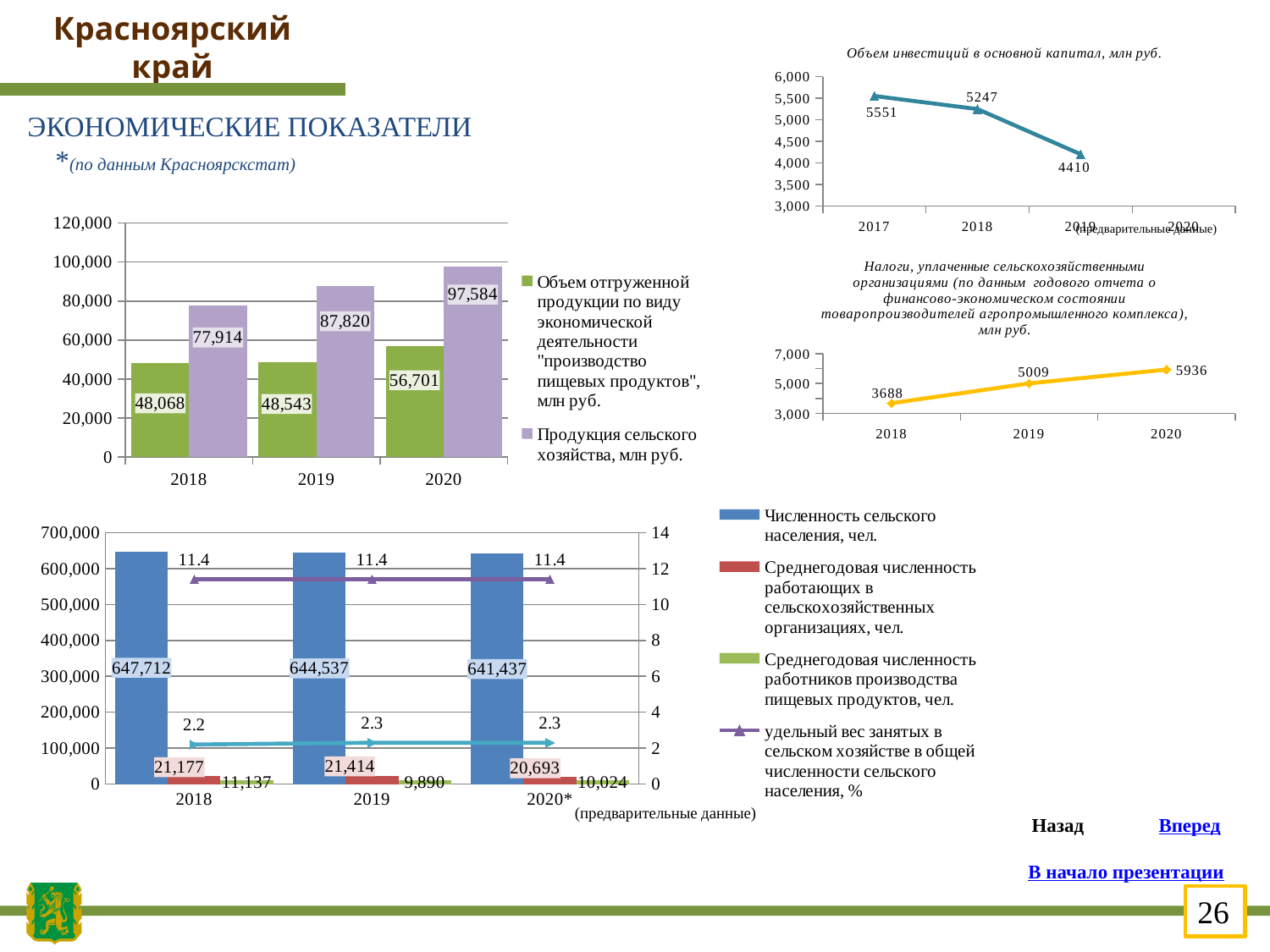
In the chart 'Объем инвестиций в основной капитал, млн руб.', what is the value for 2019? 4410 In the bottom-left chart, which is larger in 2019: 'Среднегодовая численность работающих в сельскохозяйственных организациях' or 'Среднегодовая численность работников производства пищевых продуктов'? Среднегодовая численность работающих в сельскохозяйственных организациях In the chart 'Объем инвестиций в основной капитал, млн руб.', what is the difference between the 2017 and 2018 values? 304 In the chart 'Налоги, уплаченные сельскохозяйственными организациями ..., млн руб.', what is the value for 2018? 3688 In the top-left bar chart, what is the value of 'Объем отгруженной продукции ... производство пищевых продуктов' for 2018? 48,068 In the top-left bar chart, how many series does the legend list? 2 In the bottom-left chart, what is 'Численность сельского населения, чел.' for 2020*? 641,437 In the chart 'Налоги, уплаченные сельскохозяйственными организациями ..., млн руб.', which year has the highest value? 2020 In the chart 'Объем инвестиций в основной капитал, млн руб.', do the values rise or fall from 2017 to 2019? fall In the top-left bar chart, what is the value of 'Продукция сельского хозяйства, млн руб.' for 2020? 97,584 In the top-left bar chart, in which year is 'Продукция сельского хозяйства' highest? 2020 In the top-left bar chart, what is the difference between 'Продукция сельского хозяйства' and 'Объем отгруженной продукции' in 2019? 39,277